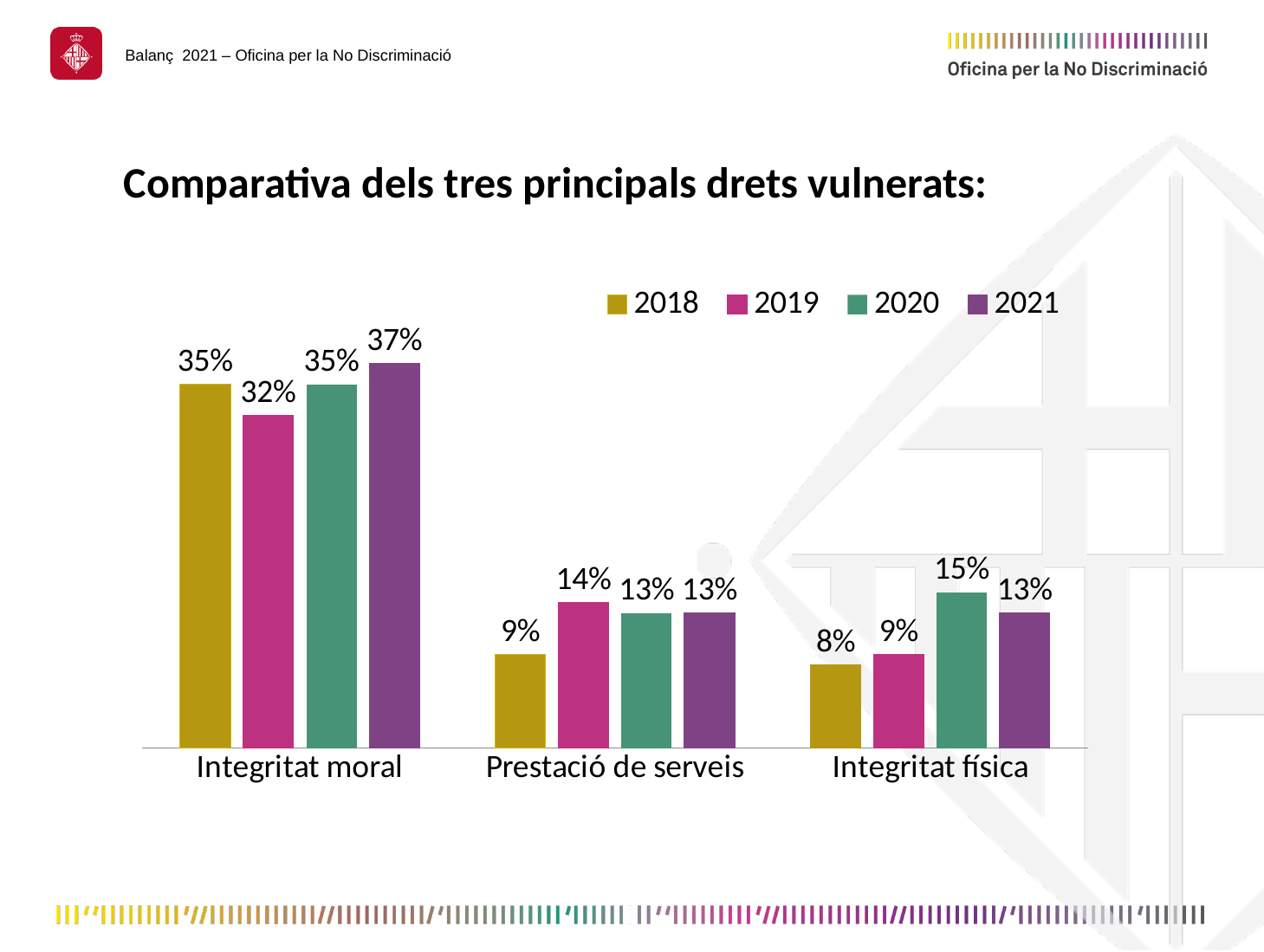
What kind of chart is shown on the slide? Bar chart Which is larger: the 2020 value for Integritat física or the 2020 value for Prestació de serveis? Integritat física What is the value for Integritat moral in 2021? 37% What is the value for Prestació de serveis in 2018? 9% Which category has the lowest value in 2018? Integritat física What is the difference between the 2021 and 2019 values for Integritat moral? 5% How many series does the legend list? 4 What is the value for Integritat física in 2020? 15% What is the value for Integritat moral in 2019? 32% Which category has the highest value in 2021? Integritat moral What is the title of the slide? Comparativa dels tres principals drets vulnerats: How many categories are shown on the x axis? 3